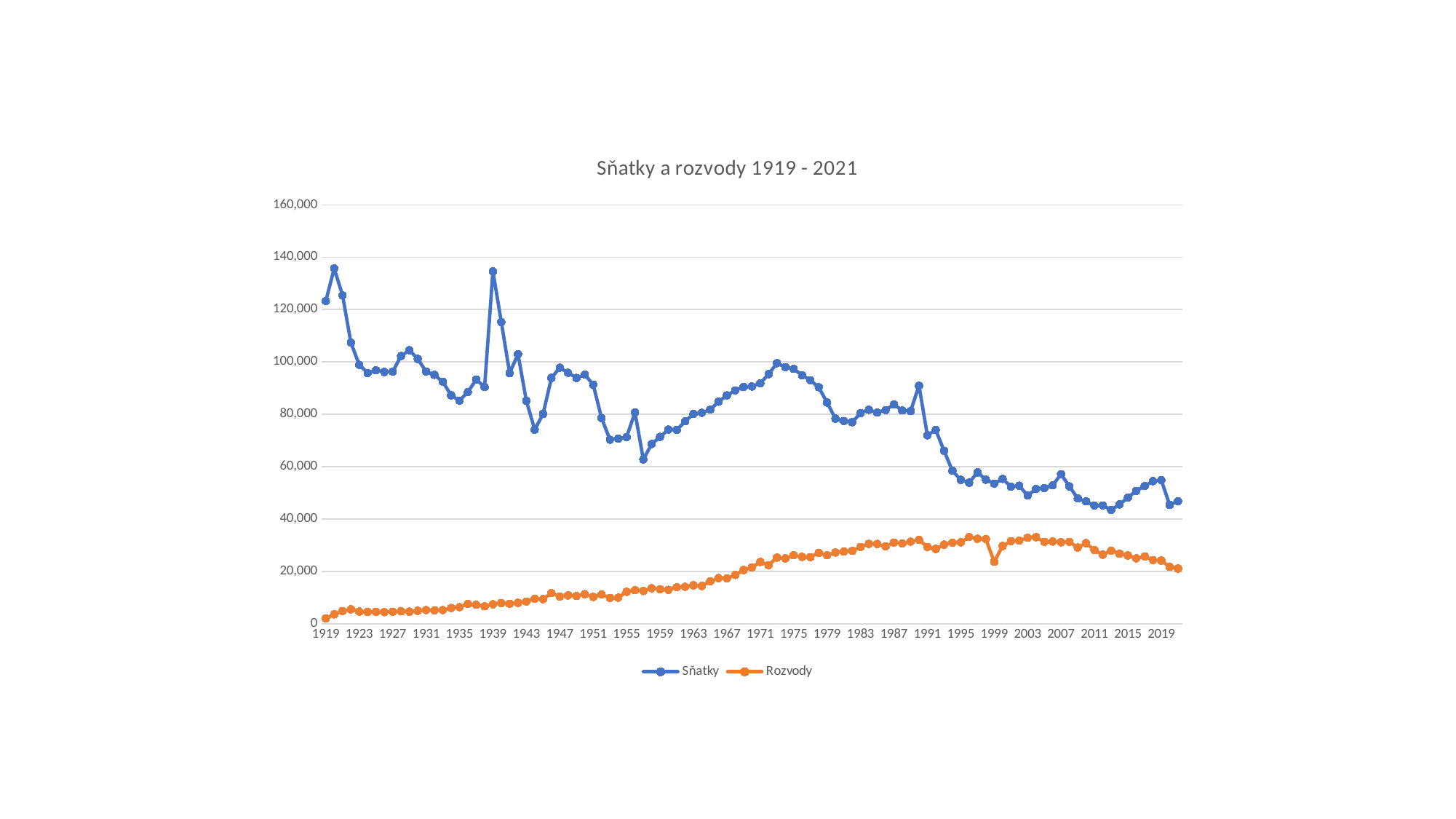
Do the values for Sňatky generally rise or fall from 1991 to 2013? fall Is the value for Rozvody in 2021 greater or less than 40,000? less Is the value for Rozvody in 2003 greater or less than 20,000? greater What is the title of the chart? Sňatky a rozvody 1919 - 2021 Is the value for Sňatky in 2013 greater or less than 60,000? less What kind of chart is shown on the slide? line chart Do the values for Rozvody generally rise or fall from 1919 to 1975? rise Which series is drawn in orange? Rozvody How many series does the legend list? 2 Which series has the larger value in 1975, Sňatky or Rozvody? Sňatky